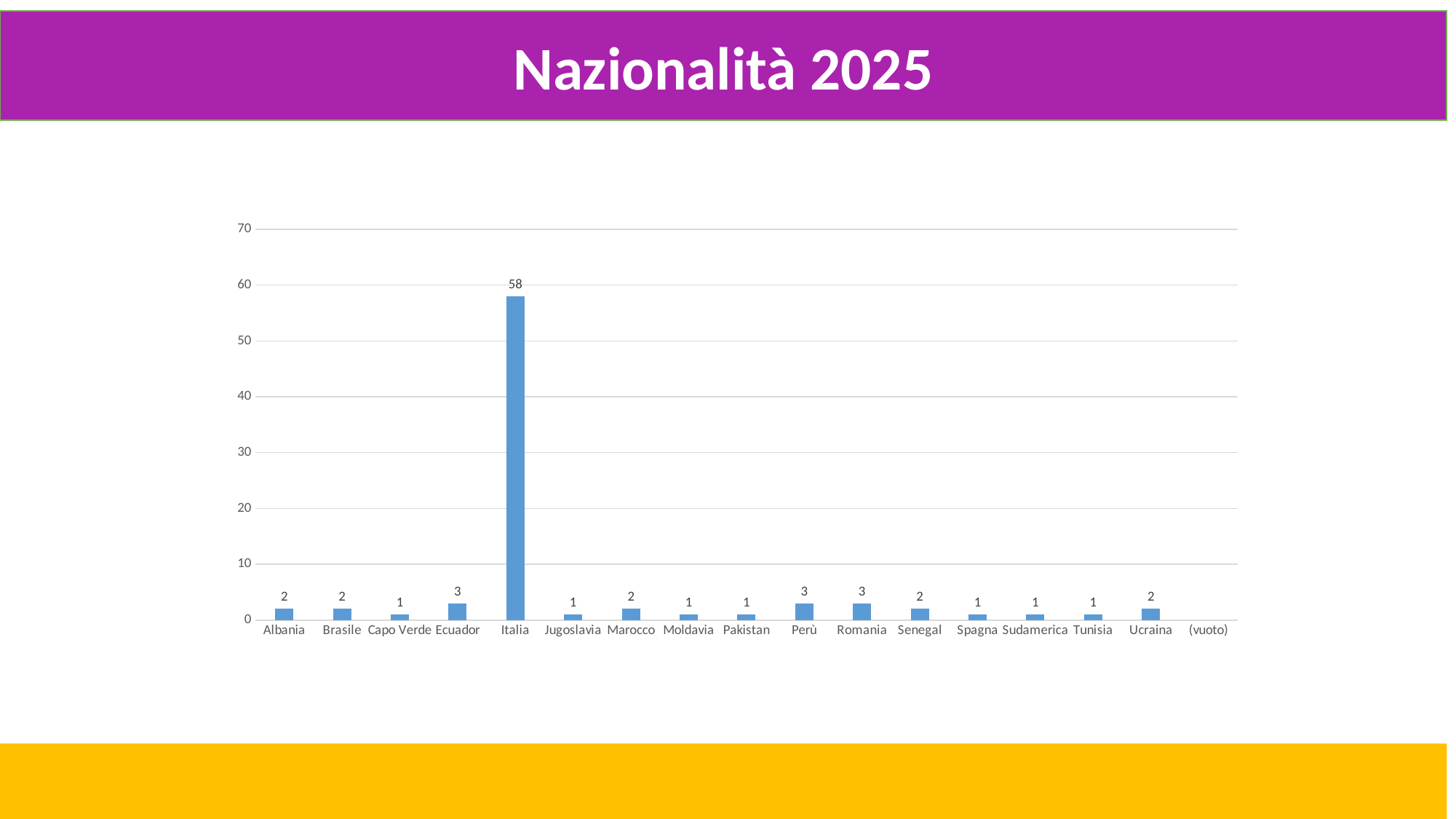
What type of chart is shown on the slide? bar chart What is the value for Ucraina? 2 What is the difference between the values for Perù and Spagna? 2 What is the difference between the values for Italia and Romania? 55 How many category labels are shown on the x axis? 17 Is the value for Italia greater or less than 50? greater Which is larger, the value for Ecuador or the value for Capo Verde? Ecuador What is the value for Ecuador? 3 What is the title shown at the top of the slide? Nazionalità 2025 What is the value for Moldavia? 1 What is the value for Italia? 58 Which category has the highest value? Italia